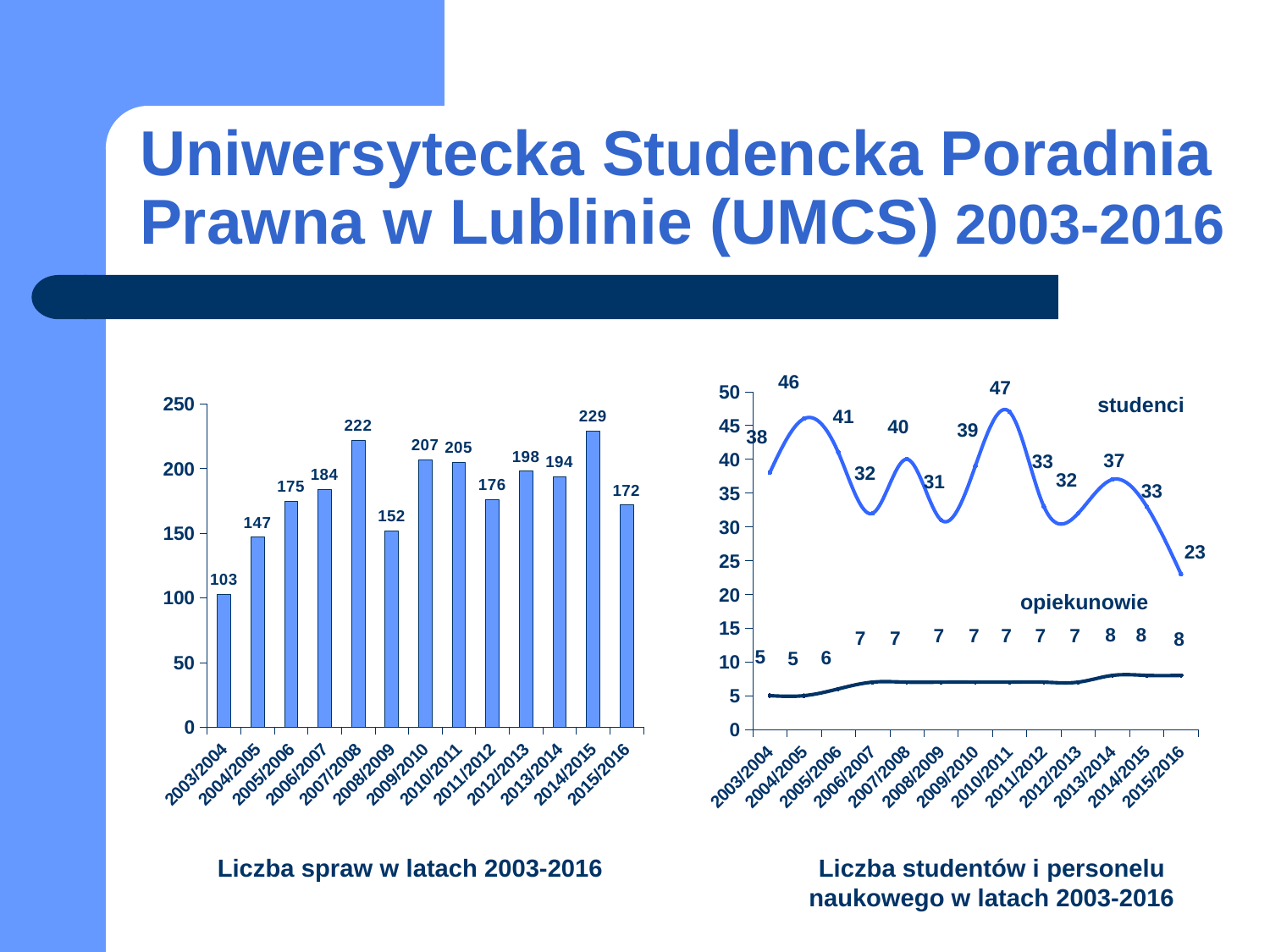
In the right chart (Liczba studentów i personelu naukowego), what is the value for studenci in 2010/2011? 47 In the left chart (Liczba spraw w latach 2003-2016), what is the difference between the values for 2014/2015 and 2015/2016? 57 What kind of chart is the left chart (Liczba spraw w latach 2003-2016)? Bar chart In the right chart (Liczba studentów i personelu naukowego), what is the value for opiekunowie in 2015/2016? 8 In the left chart (Liczba spraw w latach 2003-2016), what is the value for 2007/2008? 222 In the right chart (Liczba studentów i personelu naukowego), what is the difference between studenci and opiekunowie in 2004/2005? 41 What kind of chart is the right chart (Liczba studentów i personelu naukowego)? Line chart In the left chart (Liczba spraw w latach 2003-2016), how many years are shown on the x axis? 13 In the right chart (Liczba studentów i personelu naukowego), which year has the lowest value for studenci? 2015/2016 In the left chart (Liczba spraw w latach 2003-2016), which year has the lowest value? 2003/2004 In the left chart (Liczba spraw w latach 2003-2016), which year has the highest value? 2014/2015 In the right chart (Liczba studentów i personelu naukowego), how many series are plotted? 2